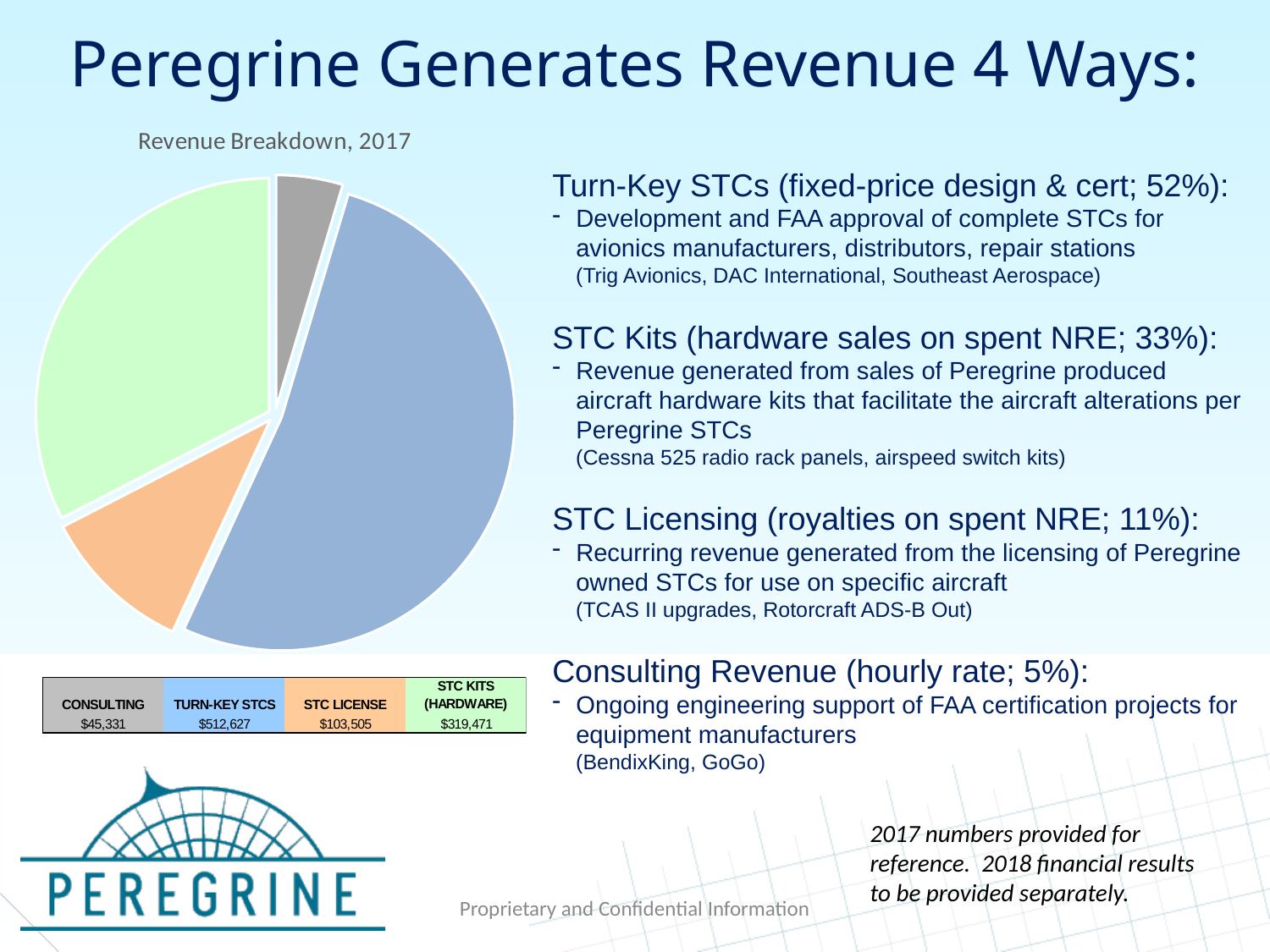
What type of chart is shown on the slide? pie chart Which category has the largest revenue? TURN-KEY STCS What is the revenue value for STC KITS (HARDWARE)? $319,471 How many categories does the pie chart have? 4 What is the revenue value for TURN-KEY STCS? $512,627 Which is larger, the revenue for STC LICENSE or for CONSULTING? STC LICENSE What is the revenue value for CONSULTING? $45,331 What is the revenue value for STC LICENSE? $103,505 What is the title of the chart? Revenue Breakdown, 2017 What is the difference between the TURN-KEY STCS revenue and the STC KITS (HARDWARE) revenue? $193,156 Which category has the smallest revenue? CONSULTING What share of total revenue does the TURN-KEY STCS slice represent? 52%